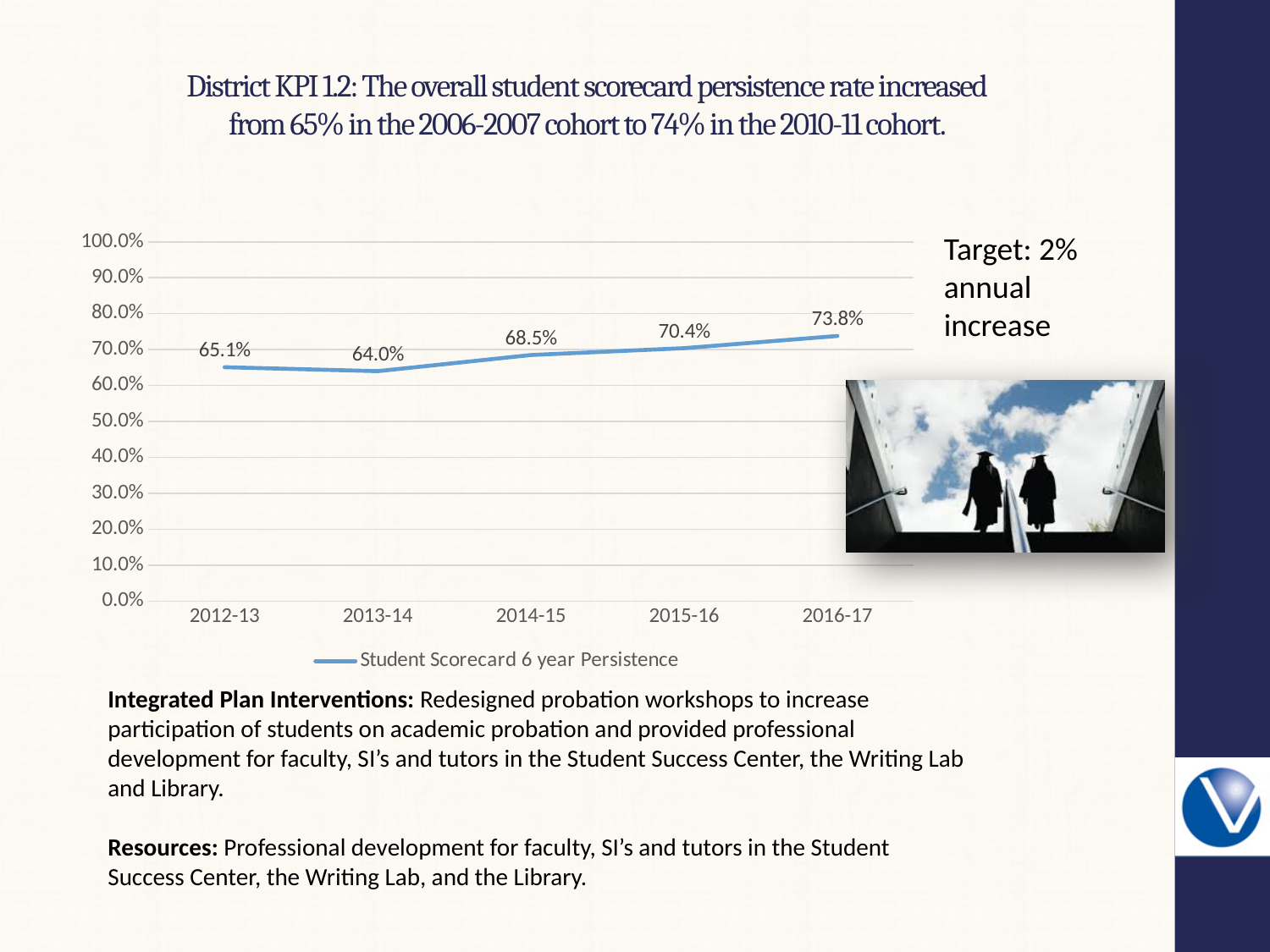
What is the name of the series shown in the legend? Student Scorecard 6 year Persistence How many series does the legend list? 1 What is the difference between the 2016-17 value and the 2012-13 value? 8.7% Which is larger, the value for 2015-16 or the value for 2014-15? 2015-16 What is the Student Scorecard 6 year Persistence value for 2016-17? 73.8% How many years are plotted on the x axis? 5 What is the value plotted for 2014-15? 68.5% What is the Student Scorecard 6 year Persistence value for 2012-13? 65.1% Which year has the highest persistence rate? 2016-17 What kind of chart is shown on the slide? line chart Which year has the lowest persistence rate? 2013-14 Is the value for 2016-17 greater or less than 80.0%? less